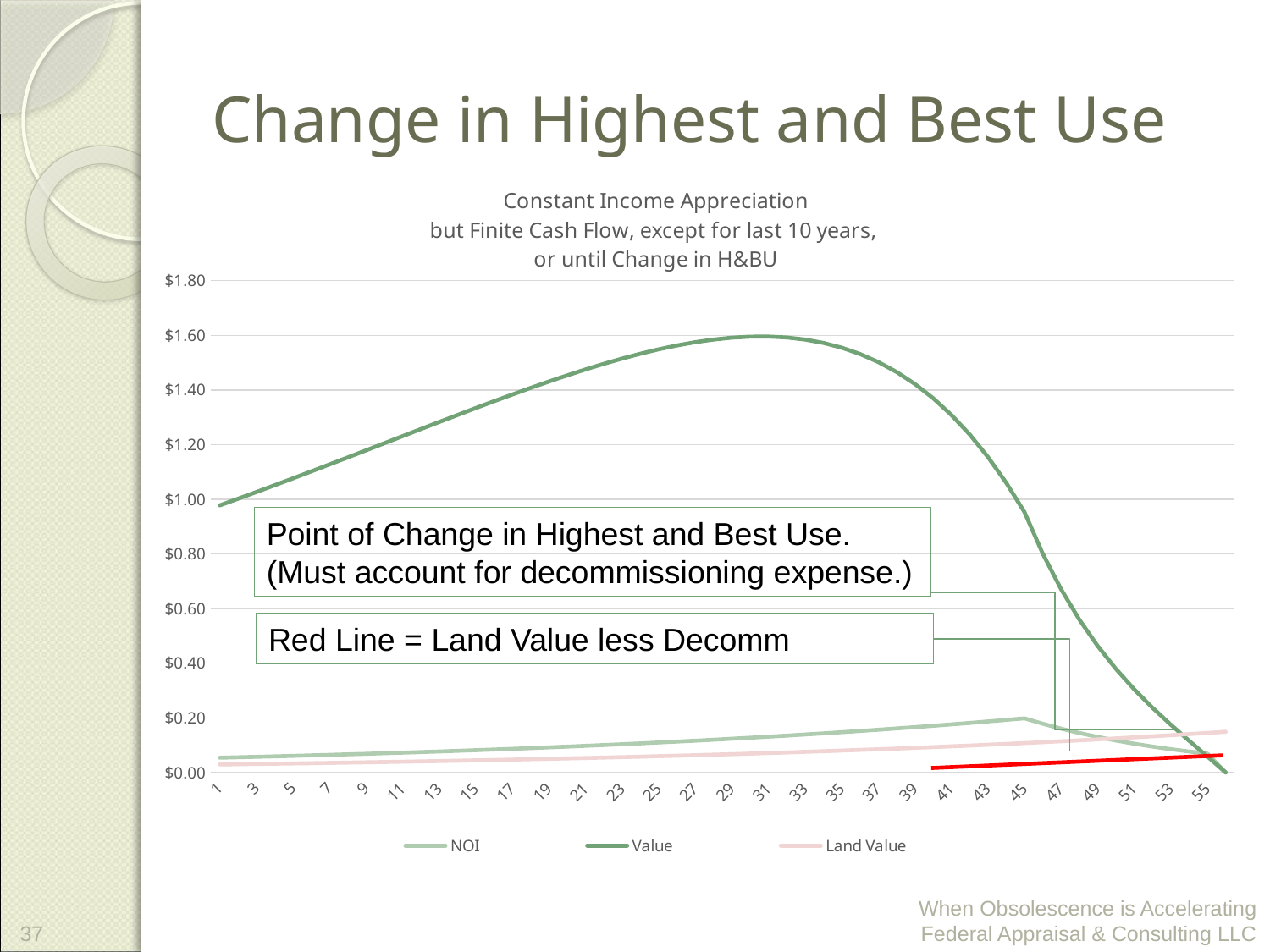
Is the Value series at year 21 greater or less than $1.40? greater Is the Value series at year 55 greater or less than $0.20? less At year 21, which series is larger, Value or NOI? Value What is the title of the chart? Constant Income Appreciation but Finite Cash Flow, except for last 10 years, or until Change in H&BU Does the Value series rise or fall between year 31 and year 55? fall What kind of chart is shown on the slide? line chart What are the three series named in the chart legend? NOI, Value, Land Value How many series does the chart legend list? 3 Is the Value series at year 51 greater or less than $0.40? less Which series reaches the highest value on the chart? Value